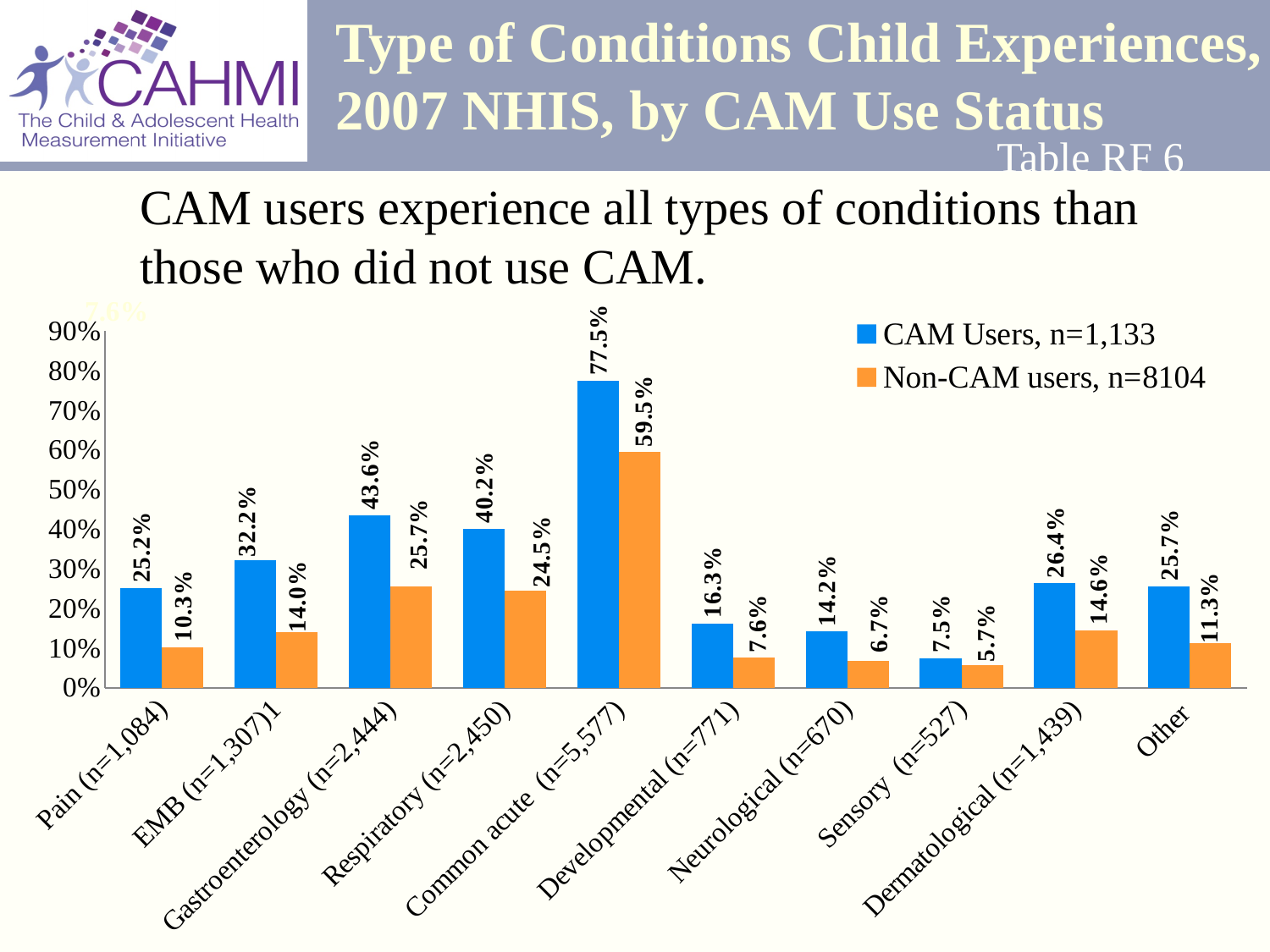
What is the value for CAM Users for Gastroenterology (n=2,444)? 43.6% What is the value for Non-CAM users for Dermatological (n=1,439)? 14.6% What is the sample size given in the legend for Non-CAM users? n=8104 What is the value for Non-CAM users for Pain (n=1,084)? 10.3% What is the value for CAM Users for Common acute (n=5,577)? 77.5% How many series does the legend list? 2 Which is larger for Neurological (n=670): the CAM Users value or the Non-CAM users value? CAM Users What is the difference between the CAM Users and Non-CAM users values for Respiratory (n=2,450)? 15.7% Which category has the lowest value for Non-CAM users? Sensory (n=527) Which category has the highest value for CAM Users? Common acute (n=5,577) What kind of chart is shown on the slide? Bar chart How many condition categories are shown on the x axis? 10